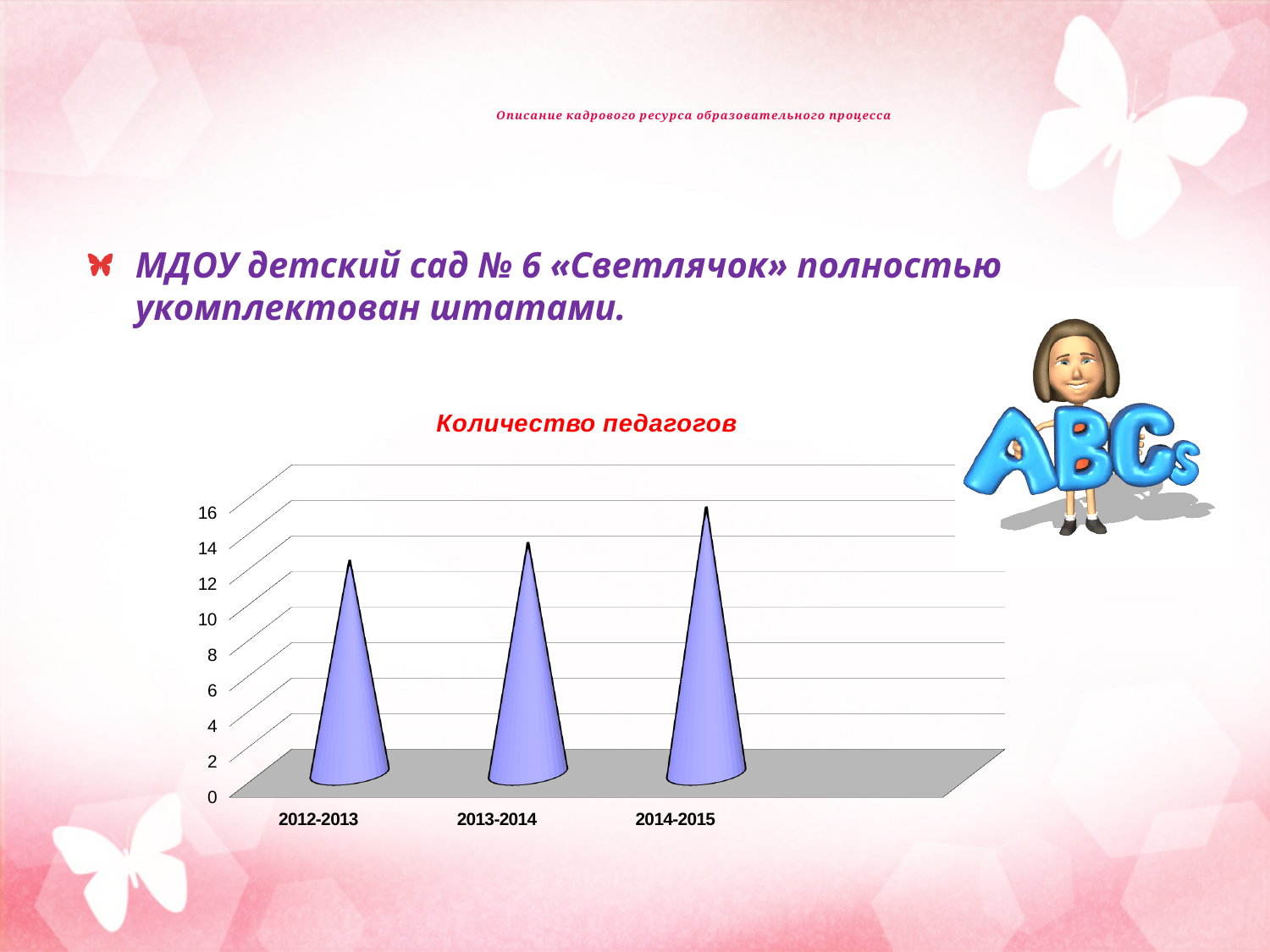
Which is larger, the value for 2013-2014 or the value for 2012-2013? 2013-2014 Is the value for 2014-2015 greater or less than 14? greater Do the values rise or fall from 2012-2013 to 2014-2015? rise Which category has the highest value in the chart? 2014-2015 What is the title of the chart on the slide? Количество педагогов Which category has the lowest value in the chart? 2012-2013 What kind of chart is shown on the slide? bar chart Is the value for 2013-2014 greater or less than 12? greater Is the value for 2012-2013 greater or less than 10? greater Which is larger, the value for 2014-2015 or the value for 2012-2013? 2014-2015 How many categories are shown on the x axis of the chart? 3 What is the highest tick value shown on the vertical axis of the chart? 16